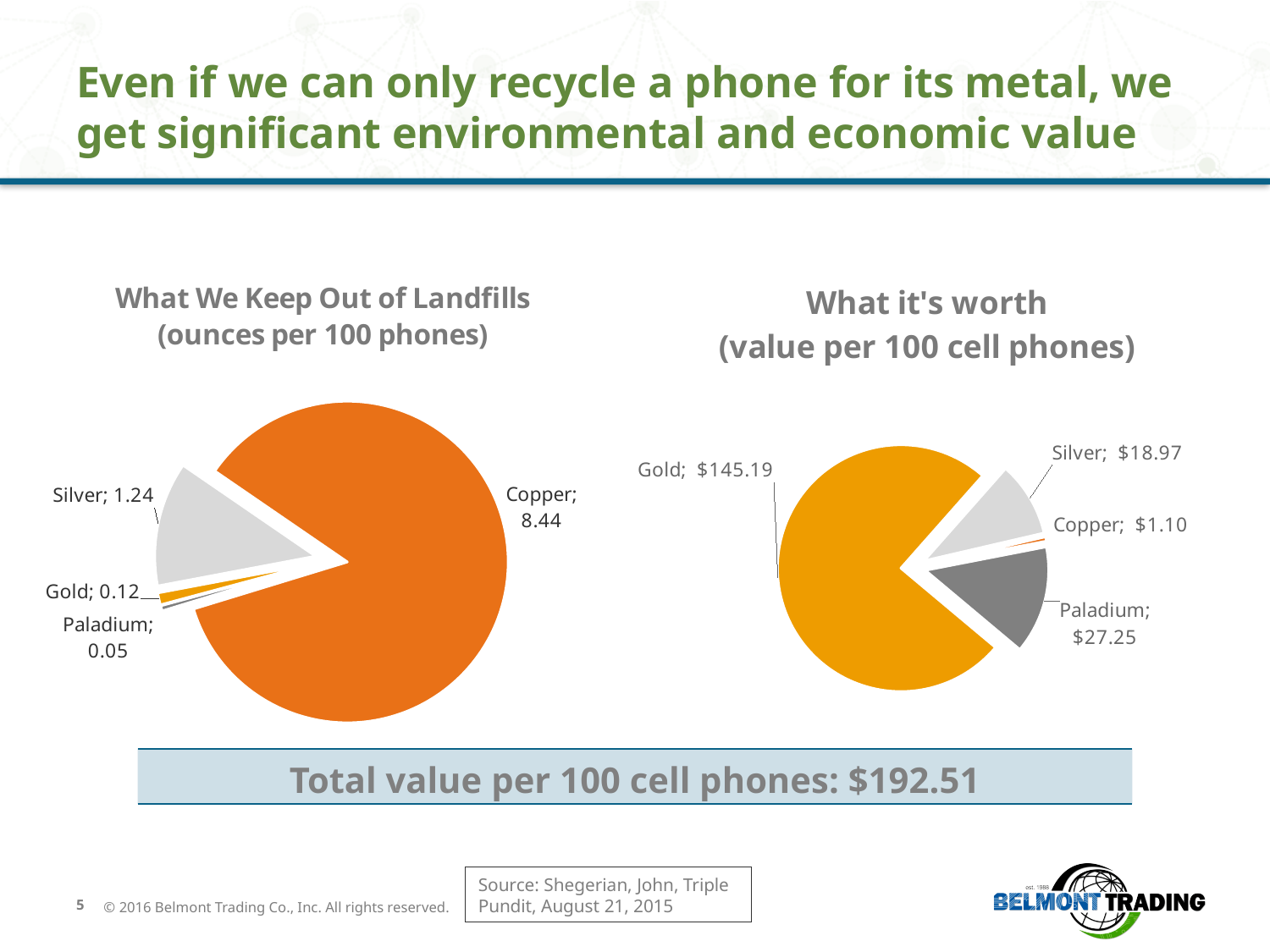
In the 'What it's worth' chart, what is the value of paladium per 100 cell phones? $27.25 In the 'What We Keep Out of Landfills' chart, which metal has the smallest number of ounces? Paladium What type of chart is used for 'What it's worth (value per 100 cell phones)'? Pie chart In the 'What it's worth' chart, which is worth more, silver or copper? Silver In the 'What We Keep Out of Landfills' chart, how many ounces of copper are kept out of landfills per 100 phones? 8.44 What is the total value per 100 cell phones shown on the slide? $192.51 In the 'What it's worth' chart, which metal has the highest value? Gold In the 'What it's worth' chart, what is the value of gold per 100 cell phones? $145.19 In the 'What it's worth' chart, how much more is gold worth than paladium? $117.94 In the 'What it's worth' chart, which metal has the lowest value? Copper In the 'What We Keep Out of Landfills' chart, what is the difference in ounces between copper and silver? 7.20 How many metals are shown in the 'What We Keep Out of Landfills' chart? 4